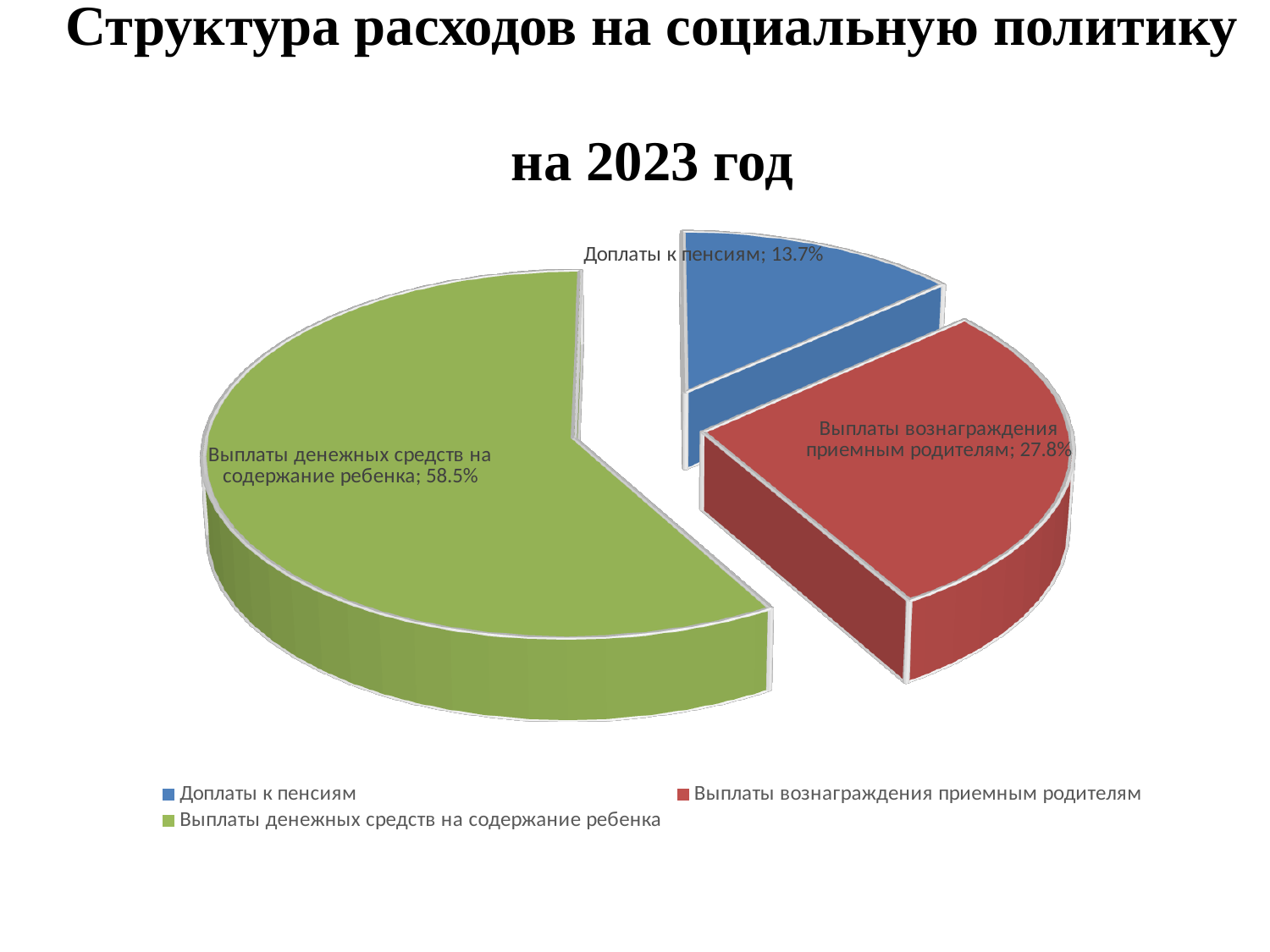
What kind of chart is shown on the slide? Pie chart What colour is the slice for "Выплаты вознаграждения приемным родителям"? Red What share of the pie does "Доплаты к пенсиям" represent? 13.7% What share of the pie does "Выплаты денежных средств на содержание ребенка" represent? 58.5% What is the difference in percentage points between "Выплаты вознаграждения приемным родителям" and "Доплаты к пенсиям"? 14.1 Which is larger: the share for "Доплаты к пенсиям" or the share for "Выплаты вознаграждения приемным родителям"? Выплаты вознаграждения приемным родителям What is the title of the chart? Структура расходов на социальную политику на 2023 год What share of the pie does "Выплаты вознаграждения приемным родителям" represent? 27.8% What is the difference in percentage points between "Выплаты денежных средств на содержание ребенка" and "Выплаты вознаграждения приемным родителям"? 30.7 How many categories (slices) does the pie chart have? 3 Which category has the smallest share of the pie? Доплаты к пенсиям Which category has the largest share of the pie? Выплаты денежных средств на содержание ребенка